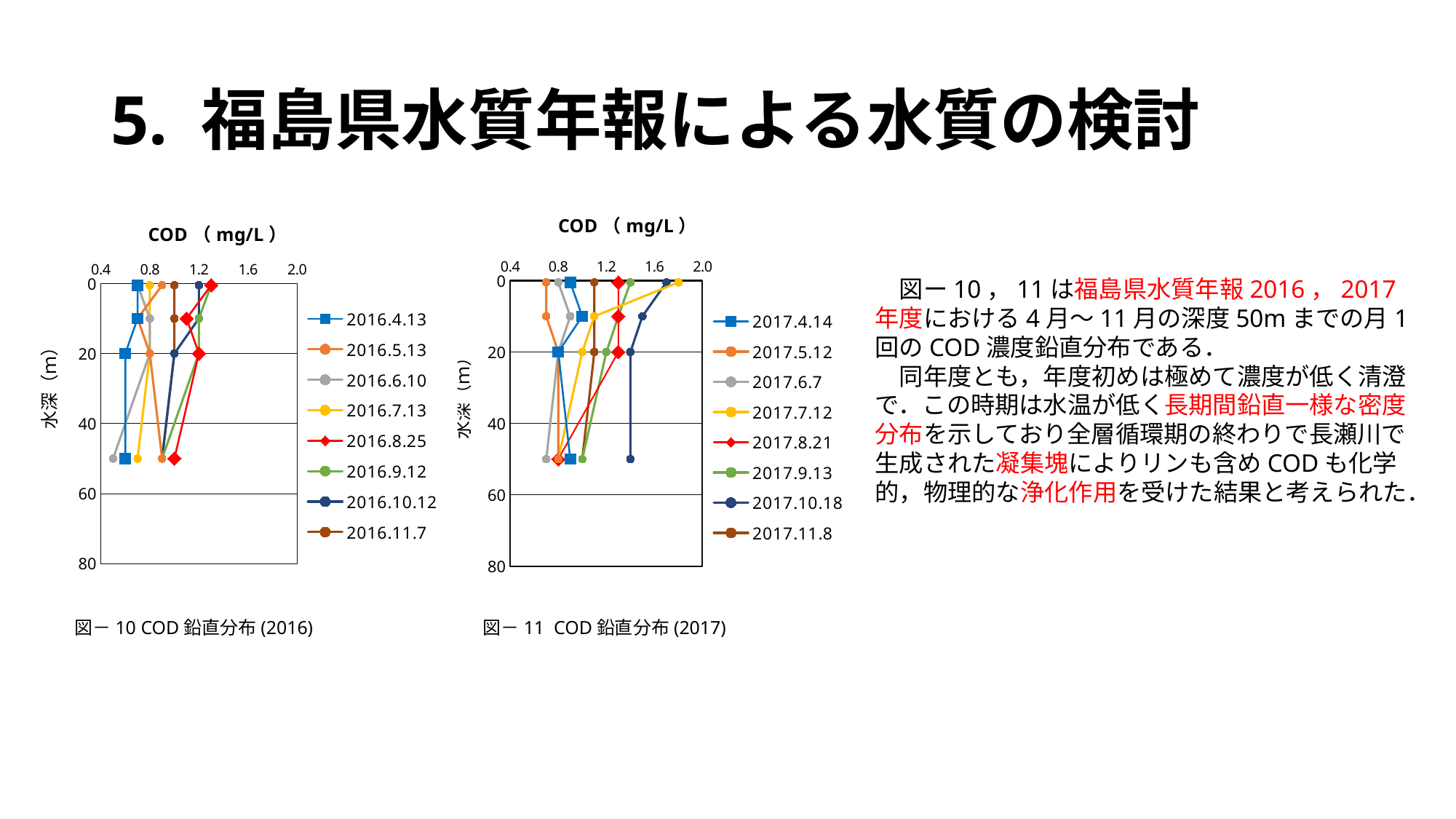
In the left chart (図－10 COD 鉛直分布 (2016)), is the COD value for 2016.6.10 at depth 50 m greater or less than 0.8? less What kind of chart is the left chart (図－10 COD 鉛直分布 (2016))? Line chart In the left chart (図－10 COD 鉛直分布 (2016)), how many series does the legend list? 8 What is the x-axis title of the left chart (図－10 COD 鉛直分布 (2016))? COD (mg/L) In the right chart (図－11 COD 鉛直分布 (2017)), how many depth points are plotted for each series? 4 In the right chart (図－11 COD 鉛直分布 (2017)), is the COD value for 2017.7.12 at depth 0 m greater or less than 1.6? greater In the left chart (図－10 COD 鉛直分布 (2016)), is the COD value for 2016.8.25 at depth 0 m greater or less than 1.2? greater In the right chart (図－11 COD 鉛直分布 (2017)), how many series does the legend list? 8 In the right chart (図－11 COD 鉛直分布 (2017)), which series has the highest COD value at depth 0 m? 2017.7.12